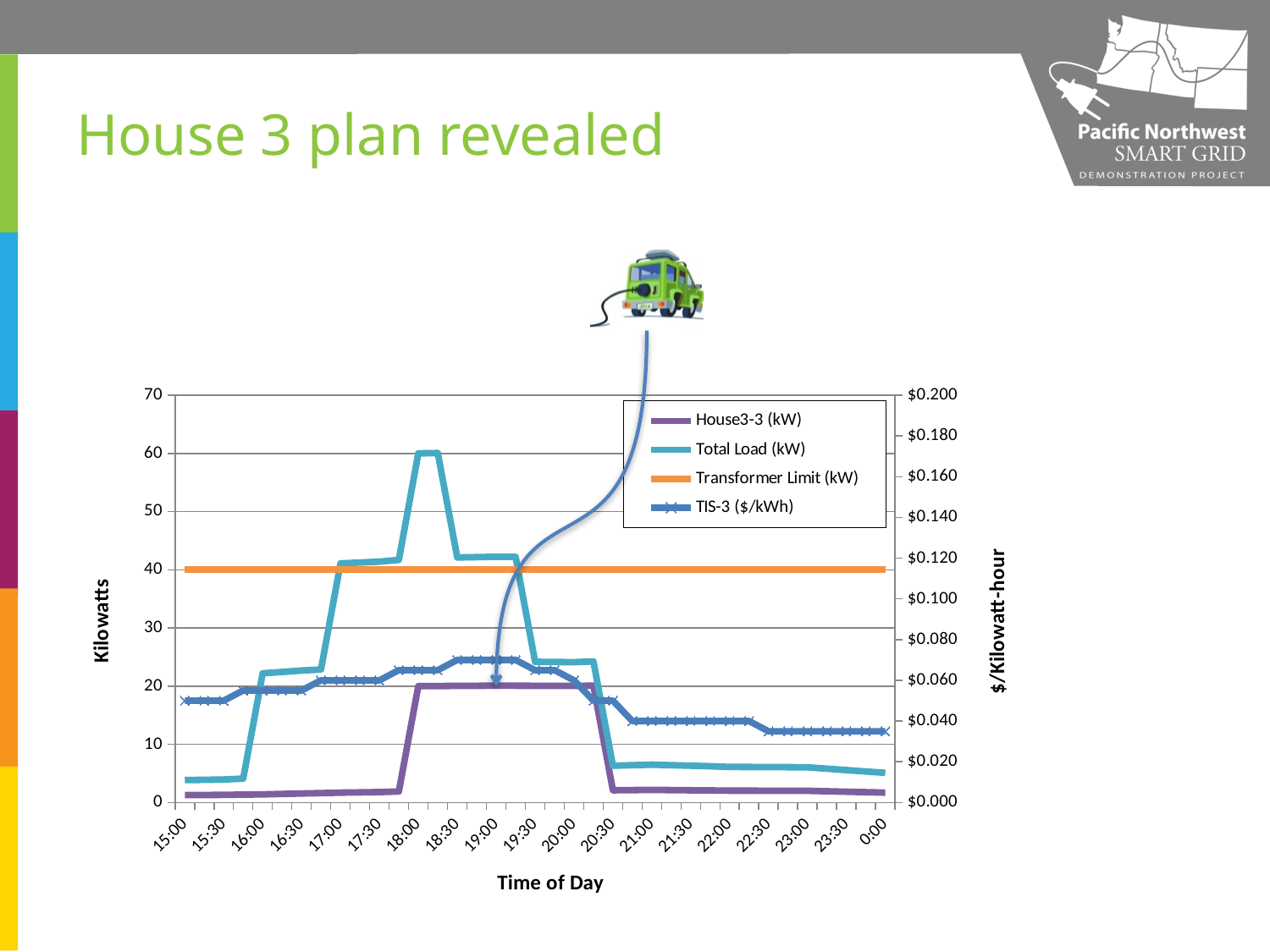
Does the TIS-3 ($/kWh) line rise or fall between 19:00 and 22:30? fall What is the TIS-3 ($/kWh) value at 21:30? $0.040 Which series reaches the highest kilowatt value on the chart? Total Load (kW) What is the title of the right-hand y axis? $/Kilowatt-hour What is the title of the x axis? Time of Day At 18:00, which is larger: Total Load (kW) or Transformer Limit (kW)? Total Load (kW) What kind of chart is shown on the slide? line chart Is the House3-3 (kW) value at 15:00 greater or less than 10? less What is the peak value of Total Load (kW), reached at 18:00? 60 Is the Total Load (kW) value at 18:00 greater or less than 50? greater How many series does the legend list? 4 What is the value of the Transformer Limit (kW) line? 40